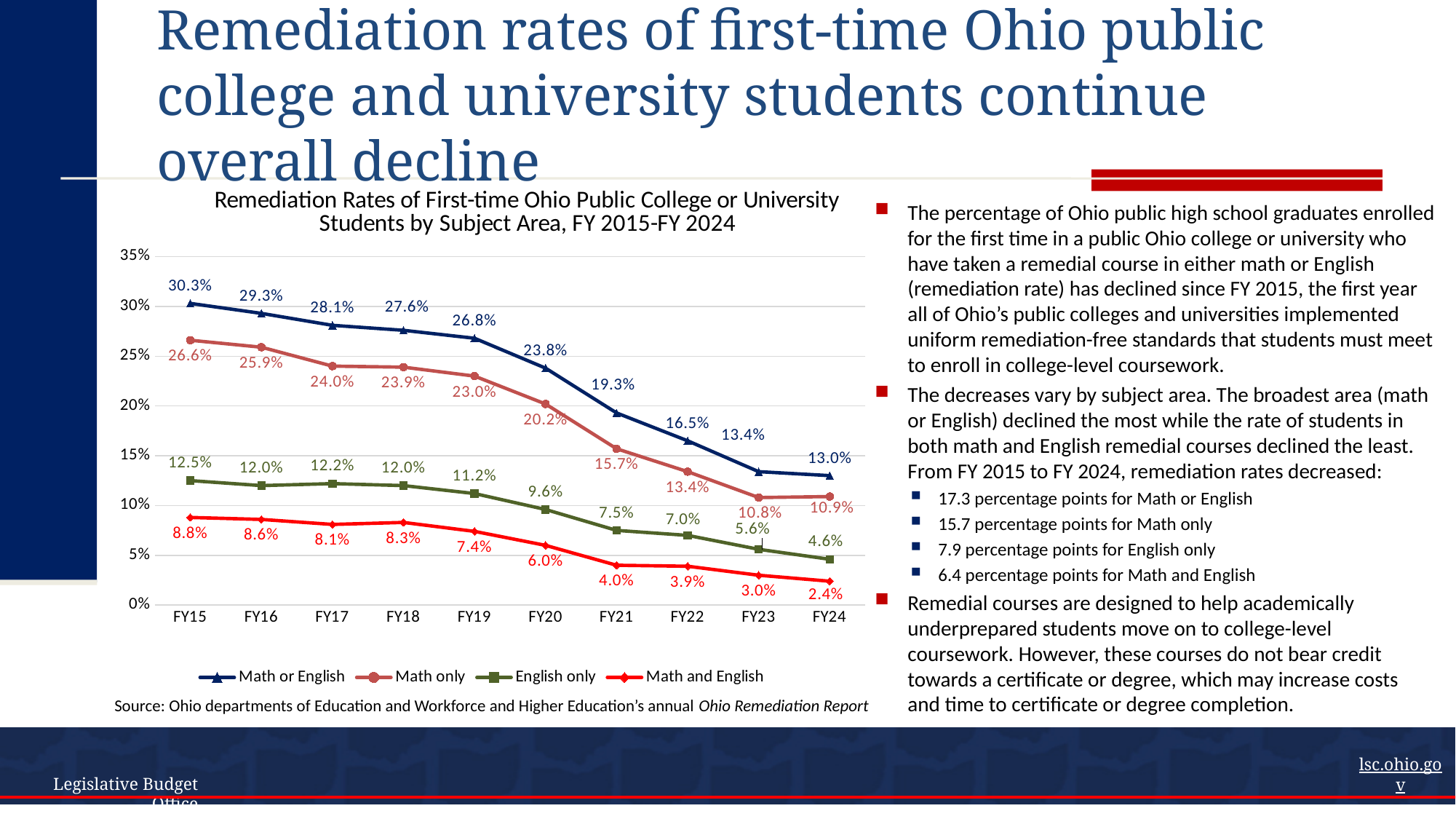
How many fiscal years are plotted along the x axis of the chart? 10 What was the Math only remediation rate in FY24? 10.9% What kind of chart is shown on the slide? Line chart What was the Math or English remediation rate in FY15? 30.3% In which fiscal year was the Math and English remediation rate lowest? FY24 In which fiscal year was the Math or English remediation rate highest? FY15 What was the English only remediation rate in FY20? 9.6% How many series does the chart's legend list? 4 What was the Math and English remediation rate in FY21? 4.0% In FY22, which was higher: the Math only rate or the English only rate? Math only Does the Math or English remediation rate rise or fall from FY15 to FY24? Fall By how many percentage points did the Math or English remediation rate fall from FY15 to FY24? 17.3 percentage points